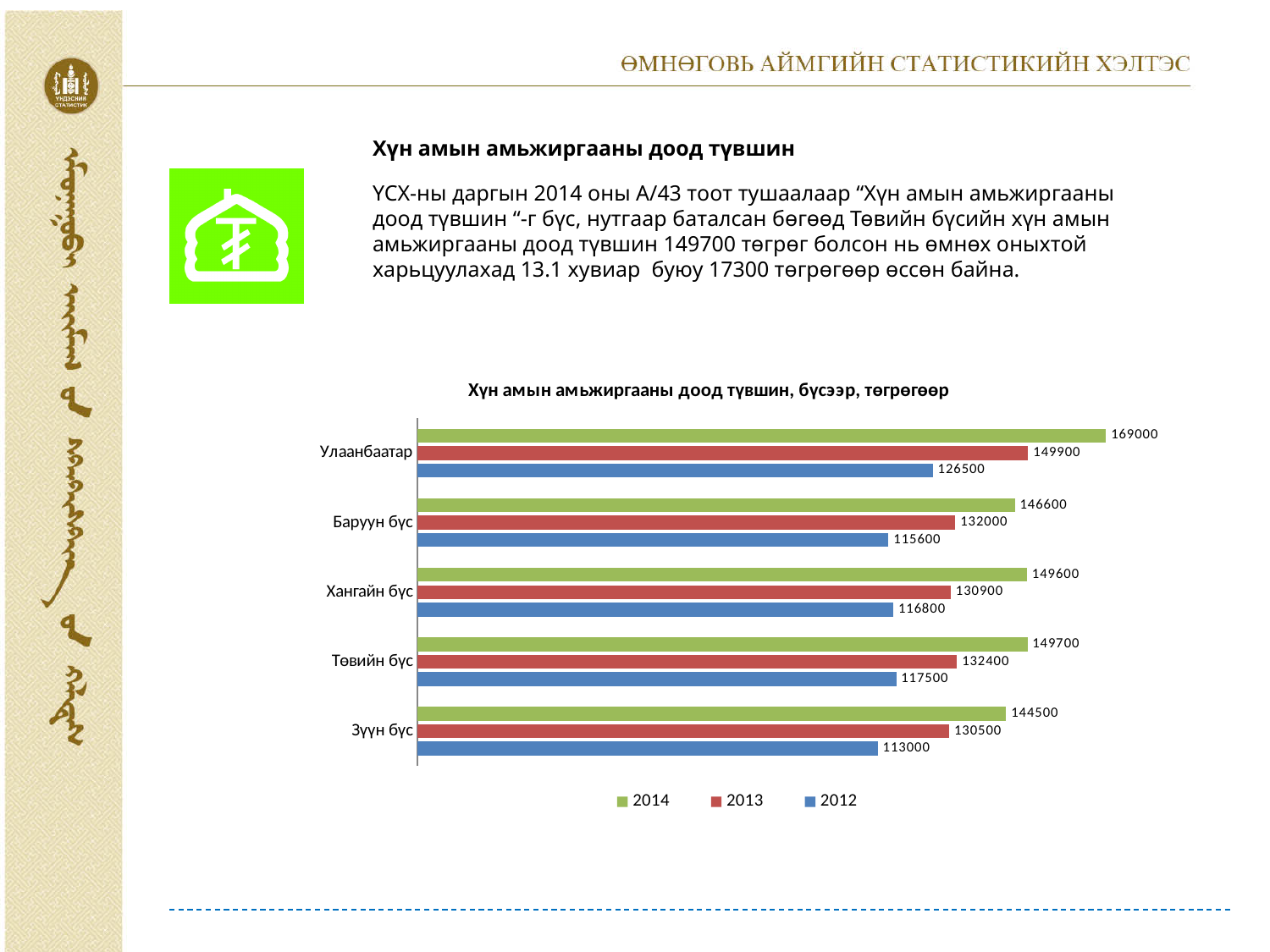
What is the difference between the 2014 and 2013 values for Төвийн бүс? 17300 Which is larger, the 2013 value for Баруун бүс or the 2013 value for Зүүн бүс? Баруун бүс Which region has the lowest 2012 value? Зүүн бүс What is the title of the chart? Хүн амын амьжиргааны доод түвшин, бүсээр, төгрөгөөр What is the 2014 value for Улаанбаатар? 169000 How many regions are shown on the chart? 5 Which region has the highest 2014 value? Улаанбаатар What is the 2013 value for Хангайн бүс? 130900 What kind of chart is shown on the slide? Bar chart What is the 2012 value for Төвийн бүс? 117500 How many series does the legend list? 3 What is the difference between the 2014 values for Улаанбаатар and Баруун бүс? 22400